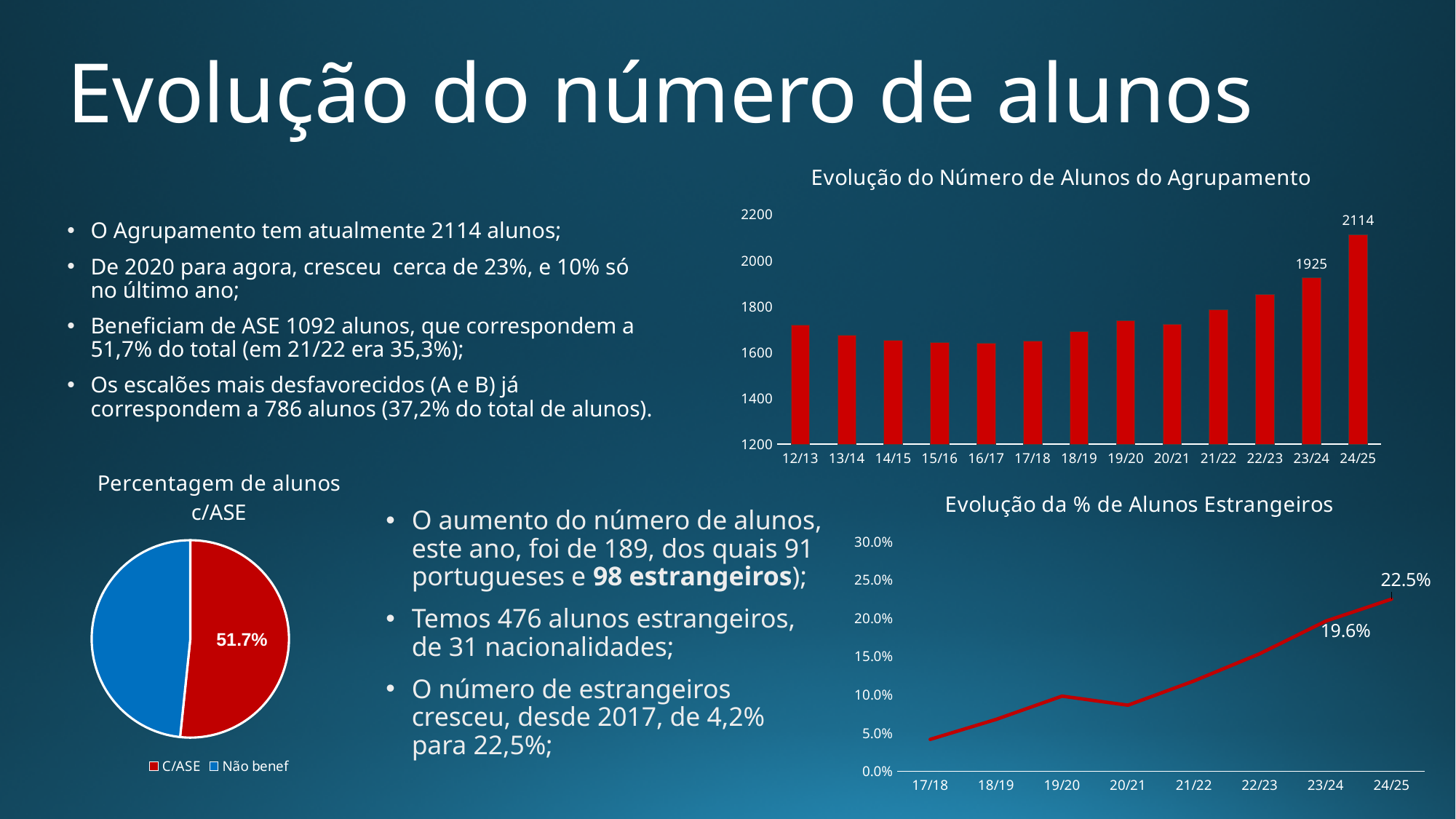
How many school years are shown on the x axis of the chart 'Evolução do Número de Alunos do Agrupamento'? 13 In the chart 'Evolução da % de Alunos Estrangeiros', do the values generally rise or fall from 17/18 to 24/25? rise In the chart 'Evolução da % de Alunos Estrangeiros', what is the value for 24/25? 22.5% In the pie chart 'Percentagem de alunos c/ASE', what share does the C/ASE slice have? 51.7% In the chart 'Evolução do Número de Alunos do Agrupamento', which school year has the highest value? 24/25 In the chart 'Evolução do Número de Alunos do Agrupamento', what is the difference between the values for 24/25 and 23/24? 189 What kind of chart is 'Evolução do Número de Alunos do Agrupamento'? bar chart In the chart 'Evolução da % de Alunos Estrangeiros', is the value for 17/18 greater or less than 5.0%? less In the chart 'Evolução do Número de Alunos do Agrupamento', what is the value for 23/24? 1925 How many entries does the legend of the pie chart 'Percentagem de alunos c/ASE' list? 2 In the chart 'Evolução do Número de Alunos do Agrupamento', is the value for 14/15 greater or less than 1800? less In the chart 'Evolução do Número de Alunos do Agrupamento', what is the value for 24/25? 2114